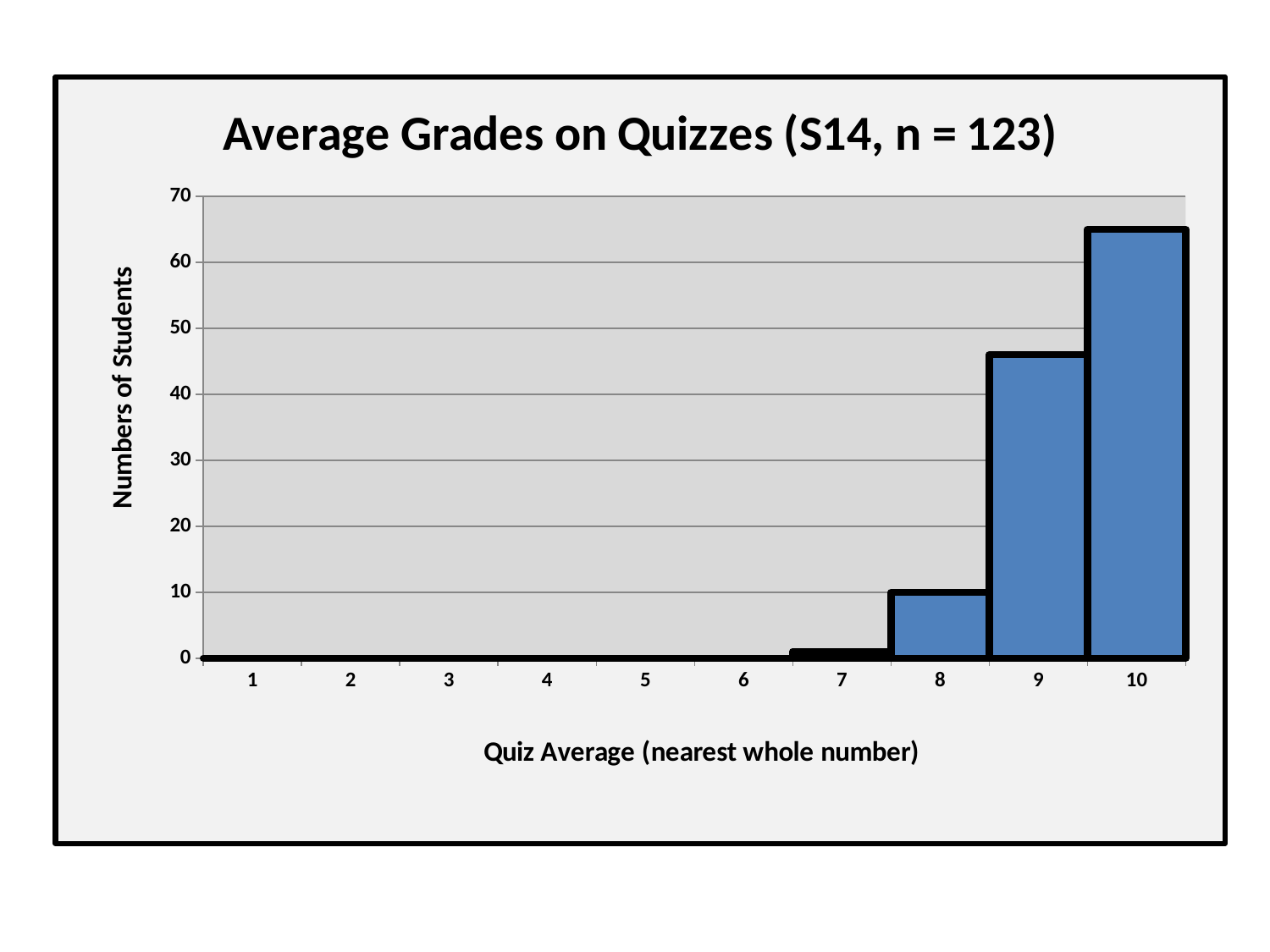
How many students have a quiz average of 8? 10 Do the numbers of students rise or fall as the quiz average goes from 7 to 10? rise Which has more students: a quiz average of 9 or a quiz average of 10? 10 How many quiz average categories are shown on the x axis? 10 Is the number of students with a quiz average of 9 greater or less than 40? greater Is the number of students with a quiz average of 7 greater or less than 10? less Is the number of students with a quiz average of 10 greater or less than 60? greater What is the title of the chart? Average Grades on Quizzes (S14, n = 123) Which quiz average category has the highest number of students? 10 What kind of chart is shown on the slide? bar chart What is the label of the vertical axis? Numbers of Students